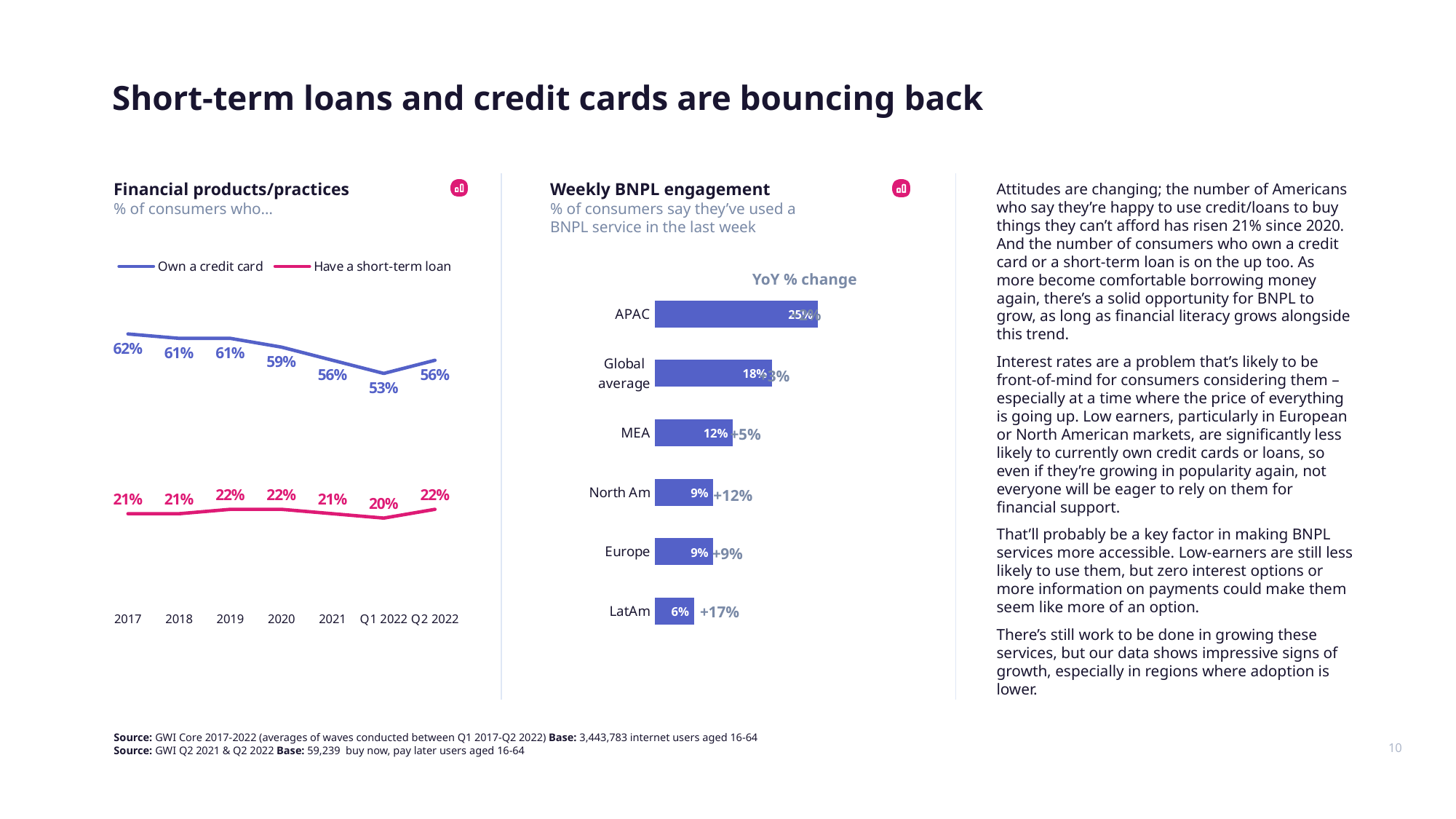
In the 'Financial products/practices' chart, what is the difference between the share owning a credit card and the share having a short-term loan in Q2 2022? 34 percentage points In the 'Financial products/practices' chart, what percentage of consumers had a short-term loan in Q1 2022? 20% In the 'Financial products/practices' chart, how many series does the legend list? 2 In the 'Weekly BNPL engagement' chart, what is the difference between the weekly BNPL engagement of APAC and MEA? 13 percentage points In the 'Financial products/practices' chart, in which period was the share of consumers owning a credit card lowest? Q1 2022 In the 'Financial products/practices' chart, what percentage of consumers owned a credit card in 2017? 62% In the 'Financial products/practices' chart, does the share of consumers owning a credit card rise or fall from 2017 to 2021? fall In the 'Weekly BNPL engagement' chart, what is the YoY % change shown for LatAm? +17% In the 'Weekly BNPL engagement' chart, what percentage of consumers in APAC say they used a BNPL service in the last week? 25% What kind of chart is 'Weekly BNPL engagement'? bar chart In the 'Financial products/practices' chart, how many time periods are shown on the x axis? 7 In the 'Weekly BNPL engagement' chart, which region has the lowest weekly BNPL engagement? LatAm